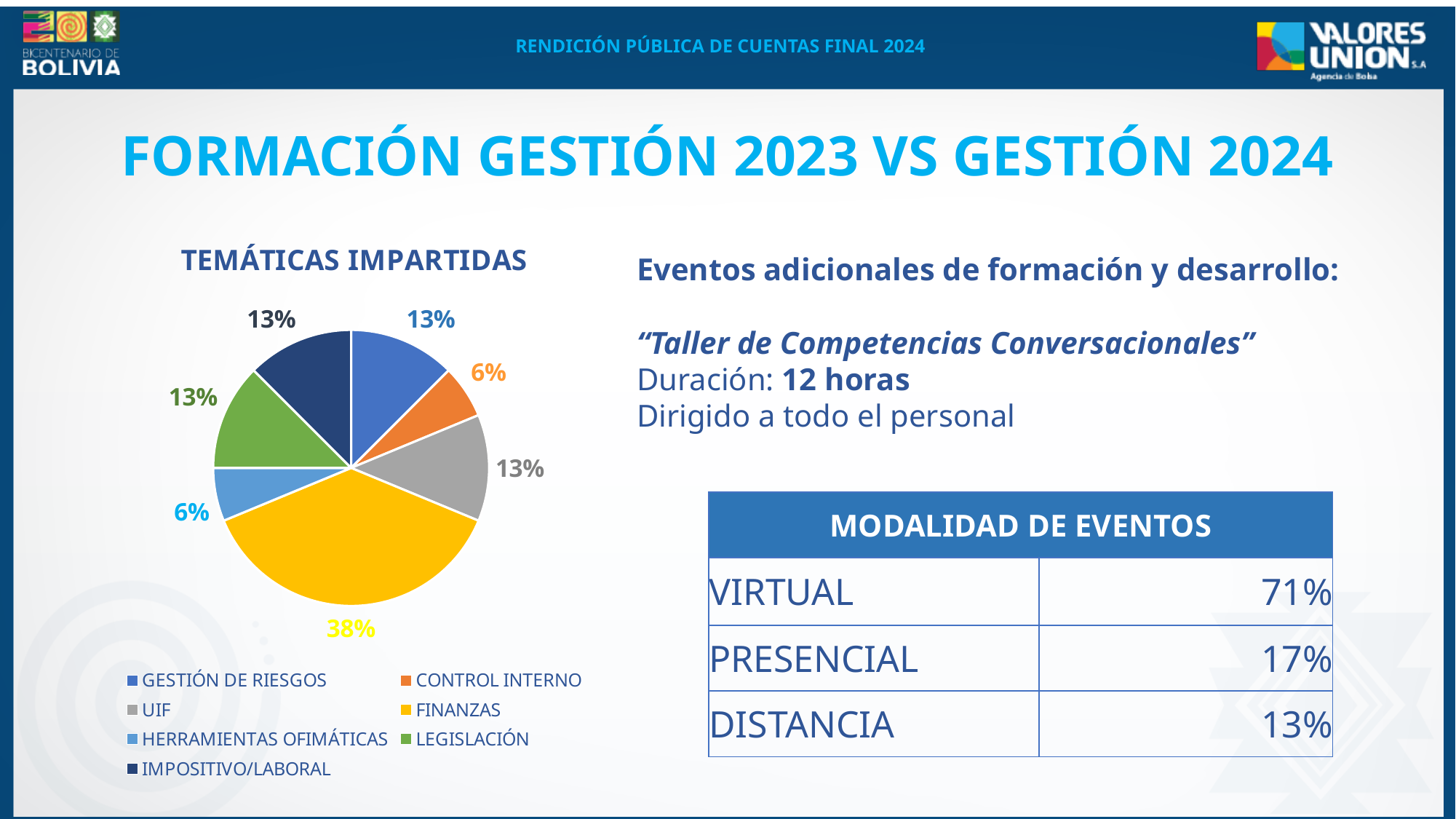
How many categories does the "TEMÁTICAS IMPARTIDAS" pie chart have? 7 In the "TEMÁTICAS IMPARTIDAS" pie chart, what share does HERRAMIENTAS OFIMÁTICAS have? 6% In the "TEMÁTICAS IMPARTIDAS" pie chart, what is the difference between the FINANZAS share and the UIF share? 25% What kind of chart is shown under the title "TEMÁTICAS IMPARTIDAS"? pie chart In the "TEMÁTICAS IMPARTIDAS" pie chart, what is the combined share of CONTROL INTERNO and HERRAMIENTAS OFIMÁTICAS? 12% In the "TEMÁTICAS IMPARTIDAS" pie chart, which category has the largest share? FINANZAS In the "TEMÁTICAS IMPARTIDAS" pie chart, what share does LEGISLACIÓN have? 13% In the "TEMÁTICAS IMPARTIDAS" pie chart, what colour is the FINANZAS slice? yellow In the "TEMÁTICAS IMPARTIDAS" pie chart, which is larger: the share for FINANZAS or the share for GESTIÓN DE RIESGOS? FINANZAS What is the title of the pie chart on the slide? TEMÁTICAS IMPARTIDAS In the "TEMÁTICAS IMPARTIDAS" pie chart, what share does CONTROL INTERNO have? 6% In the "TEMÁTICAS IMPARTIDAS" pie chart, what share does FINANZAS have? 38%